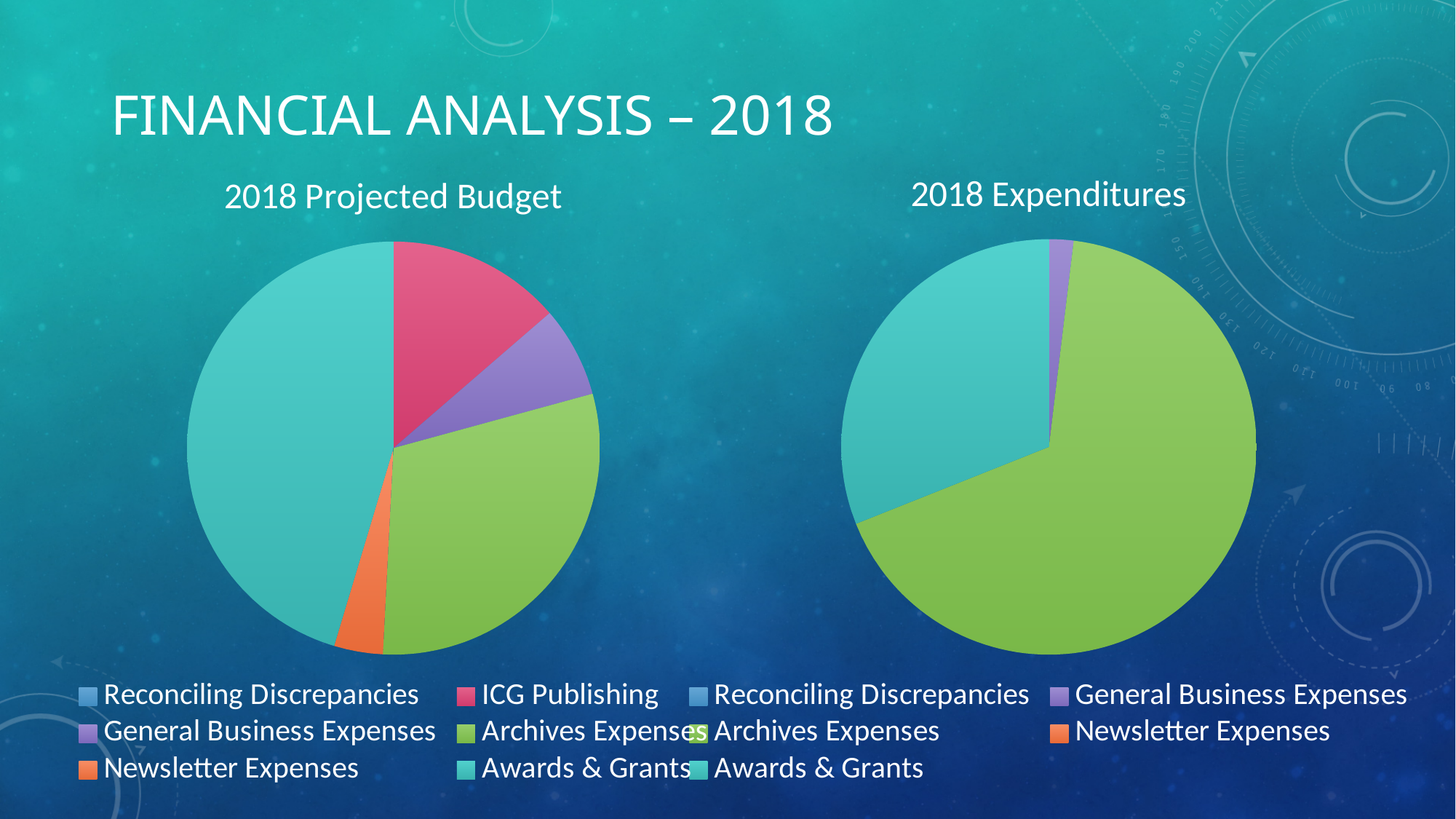
In the 2018 Expenditures chart, which is larger: Awards & Grants or General Business Expenses? Awards & Grants In the 2018 Projected Budget chart, which category has the largest slice? Awards & Grants In the 2018 Expenditures chart, which category has the largest slice? Archives Expenses What kind of chart is the 2018 Projected Budget chart? Pie chart In the 2018 Projected Budget chart, which is larger: ICG Publishing or Newsletter Expenses? ICG Publishing In the 2018 Projected Budget chart, what colour is the Awards & Grants slice? Teal How many entries does the legend of the 2018 Expenditures chart list? 5 In the 2018 Projected Budget chart, which is larger: Archives Expenses or ICG Publishing? Archives Expenses How many entries does the legend of the 2018 Projected Budget chart list? 6 What kind of chart is the 2018 Expenditures chart? Pie chart What is the title of the chart on the left of the slide? 2018 Projected Budget